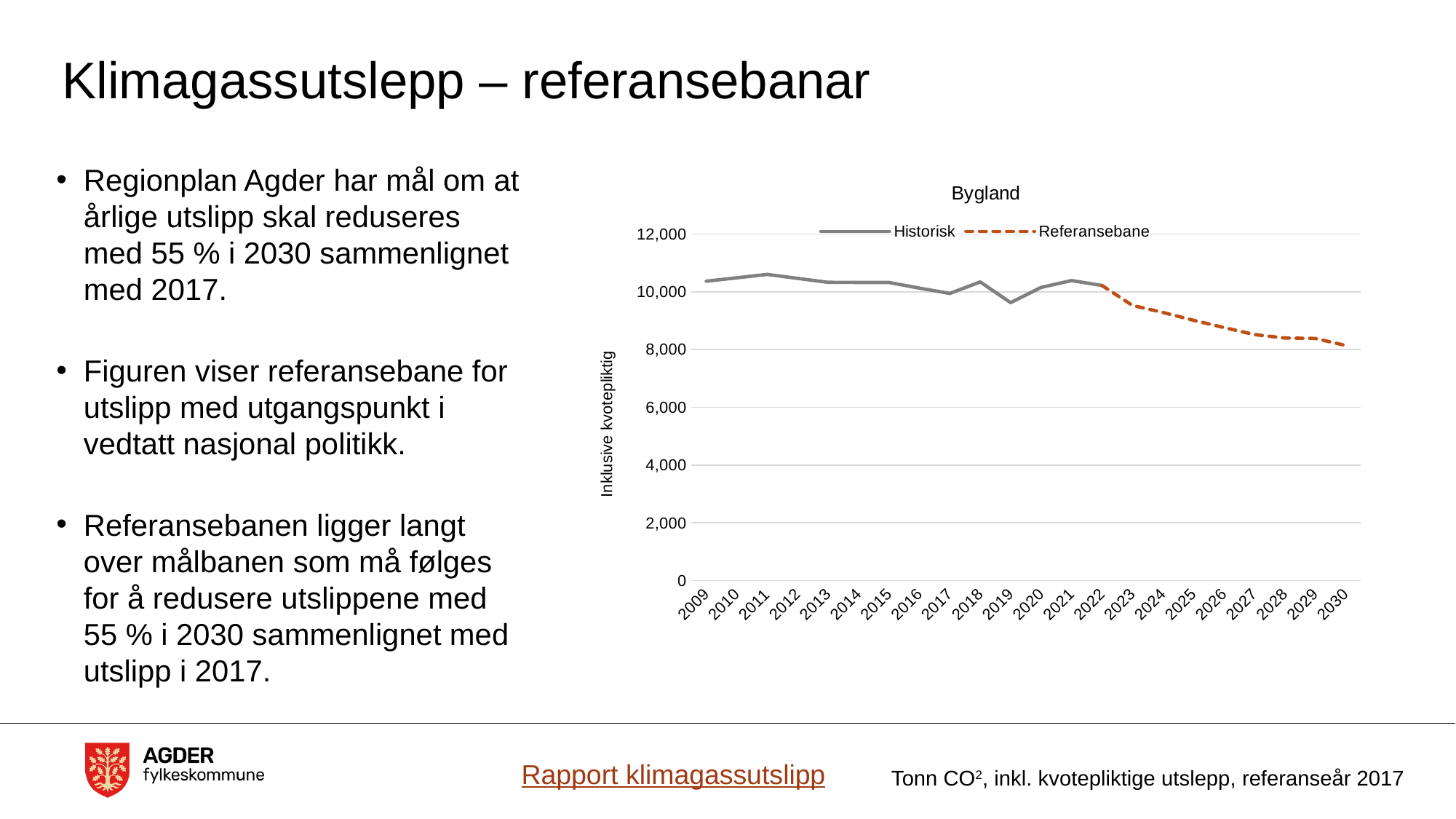
What are the names of the two series in the chart legend? Historisk and Referansebane What is the title of the chart? Bygland How many series does the chart legend list? 2 Which is larger, the Historisk value for 2021 or the Historisk value for 2019? 2021 What kind of chart is shown on the slide? Line chart Is the Historisk value for 2011 greater or less than 10,000? greater How many years are shown on the x axis of the chart? 22 In which year is the Historisk series at its lowest? 2019 Is the Historisk value for 2019 greater or less than 10,000? less Is the Referansebane value for 2030 greater or less than 10,000? less Does the Referansebane series rise or fall from 2022 to 2030? Fall In which year is the Referansebane series at its lowest? 2030